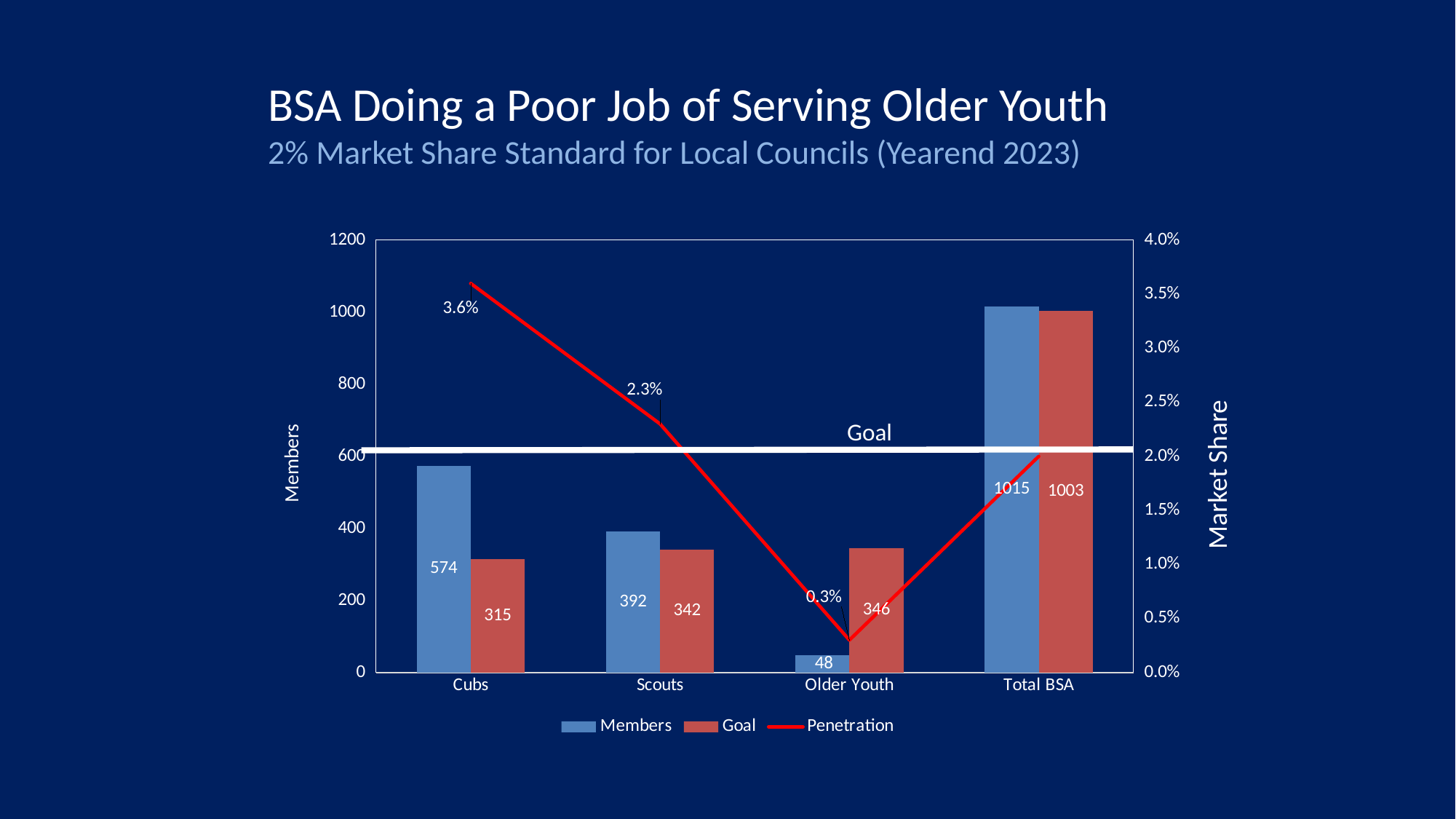
What is the label of the right-hand vertical axis? Market Share Is the Members value for Scouts larger or smaller than its Goal value? larger What is the Penetration value for Scouts? 2.3% Which category has the lowest Members value? Older Youth Is the Penetration value for Total BSA greater or less than 3.0%? less Which category has the highest Penetration value among those labeled? Cubs What is the Members value for Total BSA? 1015 What is the difference between the Goal and Members values for Older Youth? 298 What is the Members value for Cubs? 574 What is the Goal value for Older Youth? 346 How many categories are shown on the x axis? 4 How many series does the legend list? 3